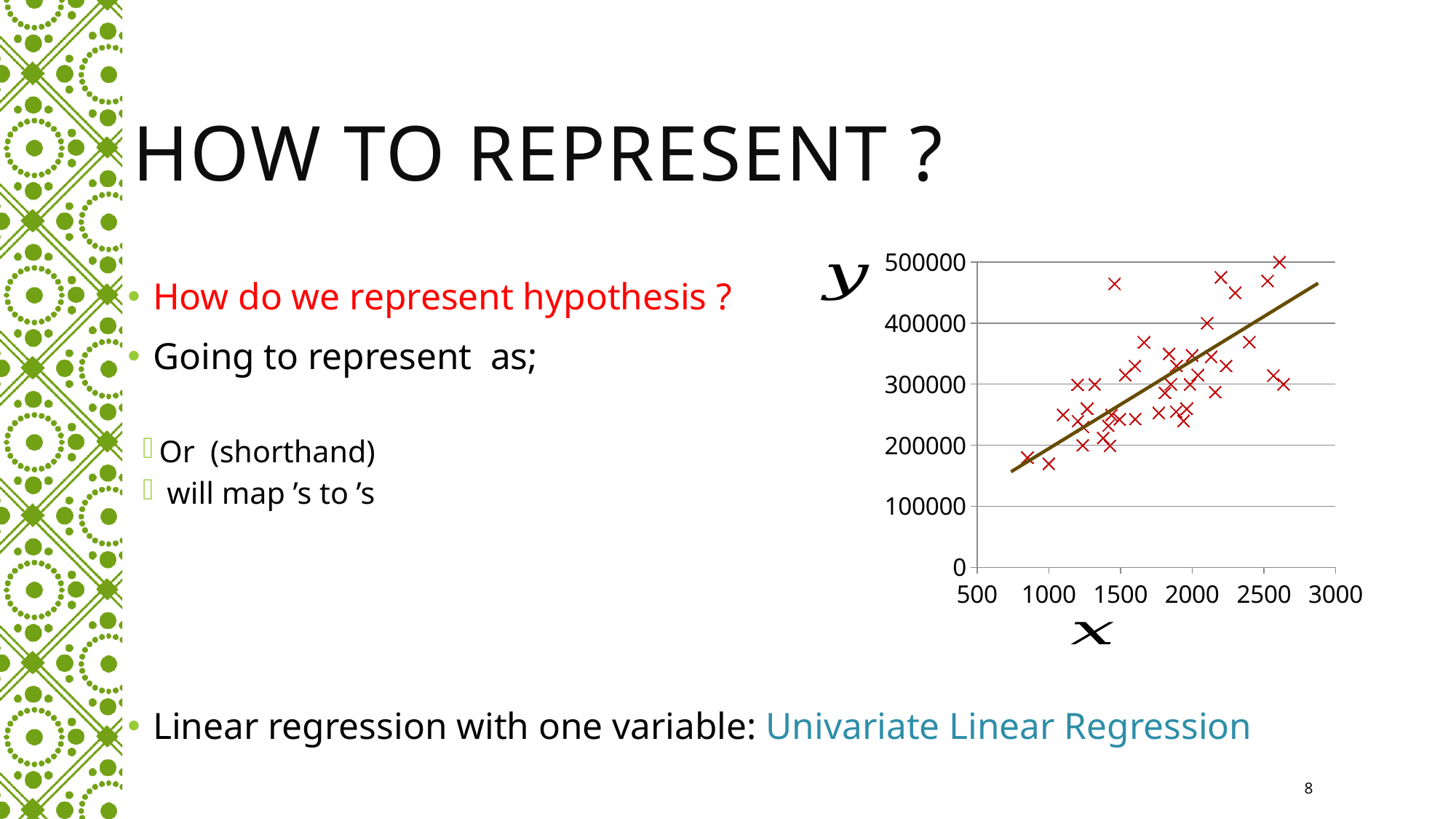
Do the plotted y values generally rise or fall as x increases? rise Is the lowest plotted point on the chart greater or less than 200000? less What is the label on the vertical axis of the chart? y What is the label on the horizontal axis of the chart? x What kind of chart is shown on the slide? scatter chart Does the fitted line on the chart slope upward or downward as x increases? upward Is the highest plotted point on the chart greater or less than 400000? greater